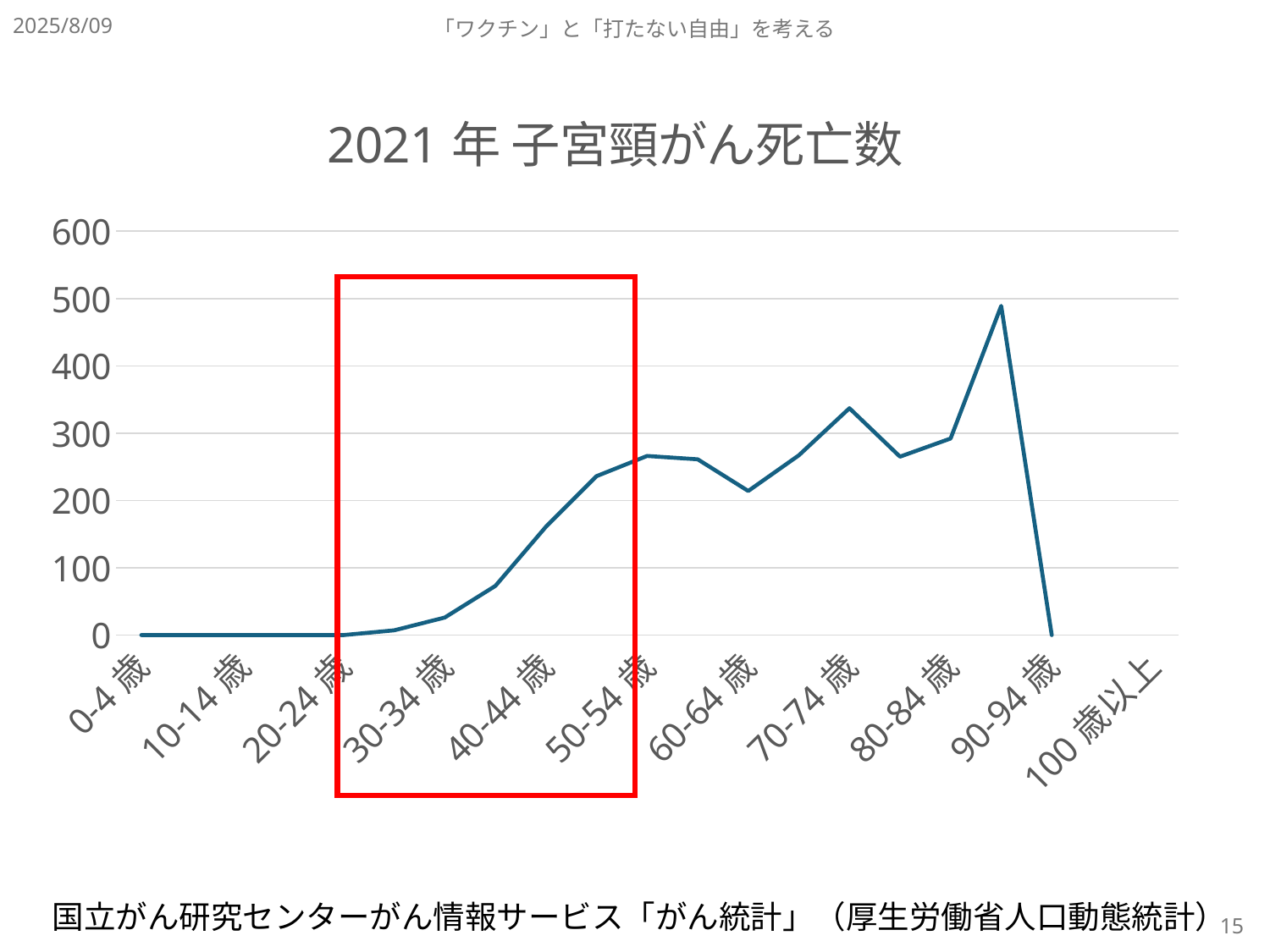
What is the value for 0-4歳? 0 Which age range on the x axis is enclosed by the red box? 30-34歳 to 50-54歳 Do the values rise or fall from 20-24歳 to 50-54歳? rise Is the value for 40-44歳 greater or less than 200? less Is the value for 50-54歳 greater or less than 200? greater Is the value for 70-74歳 greater or less than 300? greater Which is larger, the value for 70-74歳 or the value for 60-64歳? 70-74歳 What is the title of the chart? 2021 年 子宮頸がん死亡数 What kind of chart is shown on the slide? line chart